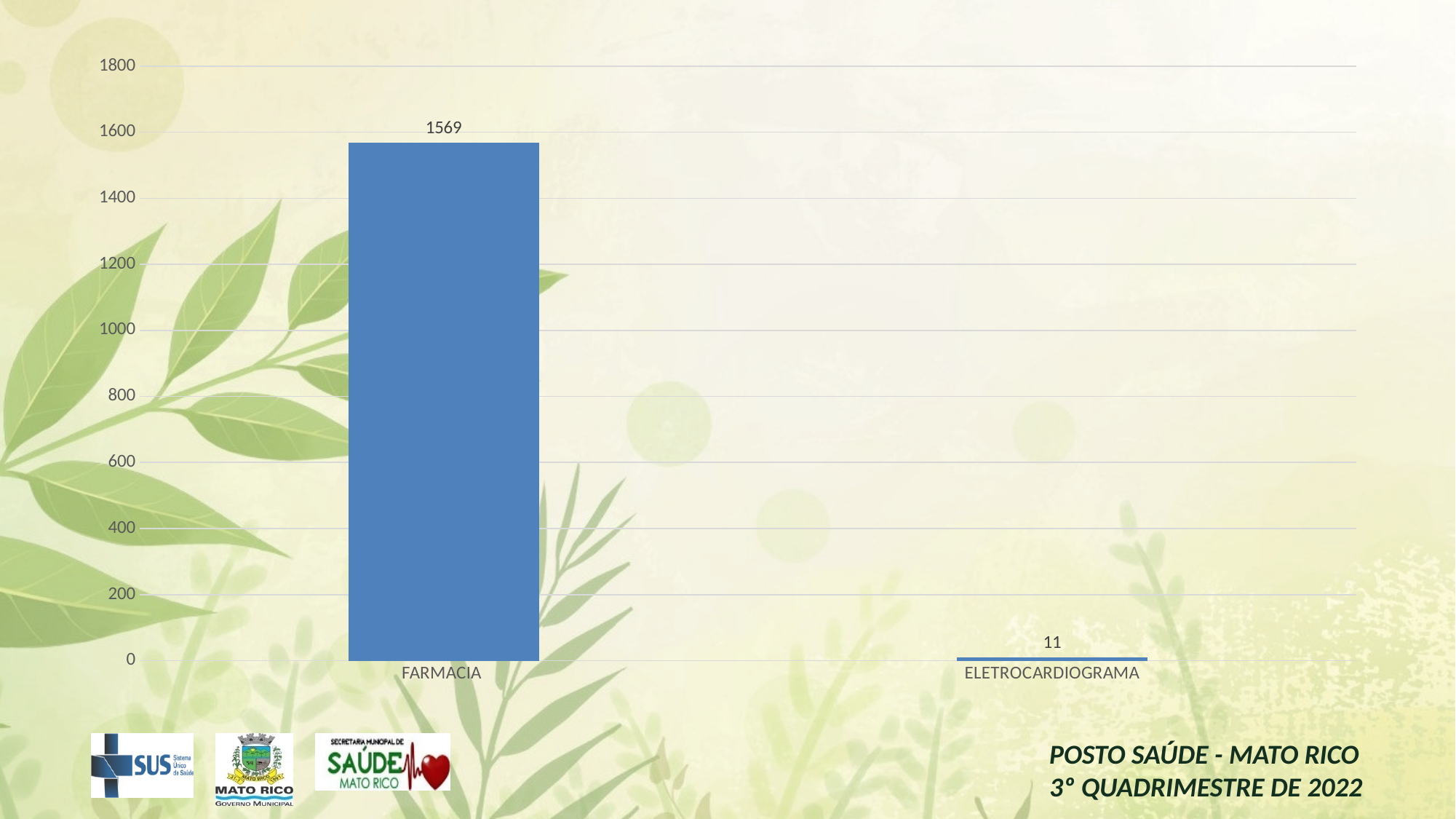
What kind of chart is shown on the slide? bar chart How many categories are shown on the chart? 2 What is the value for ELETROCARDIOGRAMA? 11 Which is larger, the value for FARMACIA or the value for ELETROCARDIOGRAMA? FARMACIA Is the value for FARMACIA greater or less than 1400? greater What is the difference between the values for FARMACIA and ELETROCARDIOGRAMA? 1558 What colour are the bars in the chart? blue What is the highest value shown on the vertical axis? 1800 What is the value for FARMACIA? 1569 Which category has the lowest value? ELETROCARDIOGRAMA Is the value for ELETROCARDIOGRAMA greater or less than 200? less Which category has the highest value? FARMACIA